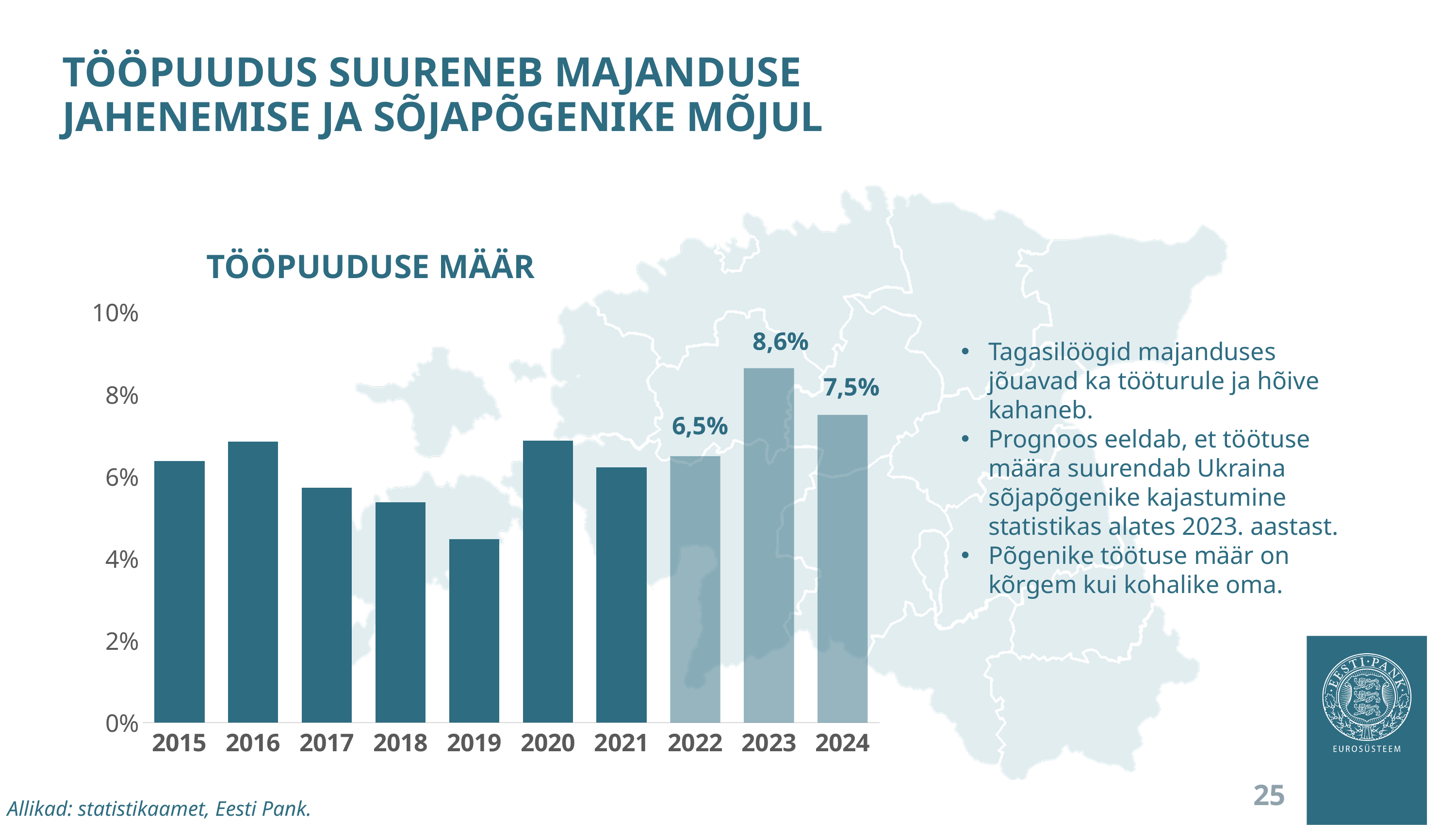
What value is labelled for 2022 in the TÖÖPUUDUSE MÄÄR chart? 6,5% Which year has the lowest bar in the TÖÖPUUDUSE MÄÄR chart? 2019 Is the value for 2016 greater or less than 6%? greater By how much does the labelled value for 2023 exceed the labelled value for 2024? 1,1 percentage points Is the value for 2019 greater or less than 6%? less What is the unemployment rate shown for 2023 in the TÖÖPUUDUSE MÄÄR chart? 8,6% By how much does the labelled value for 2024 exceed the labelled value for 2022? 1,0 percentage points What value is labelled for 2024 in the TÖÖPUUDUSE MÄÄR chart? 7,5% Which is larger, the value for 2022 or the value for 2024? 2024 Which year has the highest bar in the TÖÖPUUDUSE MÄÄR chart? 2023 What kind of chart is the TÖÖPUUDUSE MÄÄR chart? Bar chart How many years are shown on the x axis of the TÖÖPUUDUSE MÄÄR chart? 10